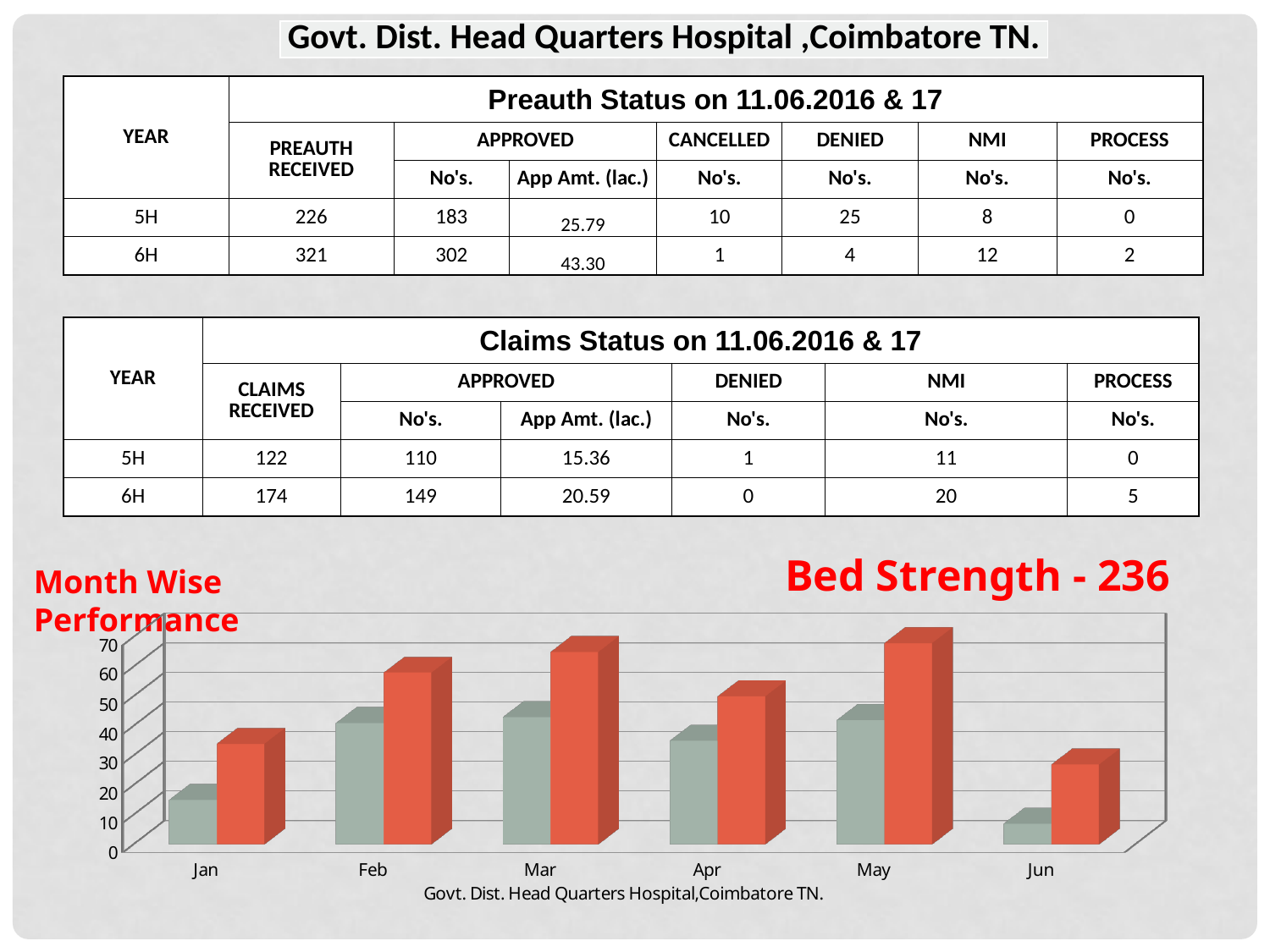
In the Month Wise Performance chart, is the red bar for May greater or less than 60? greater In the Month Wise Performance chart, which month has the lowest red bar? Jun In the Month Wise Performance chart, which is larger, the red bar for Feb or the red bar for Jan? Feb In the Month Wise Performance chart, is the grey bar for Jun greater or less than 10? less How many months are shown on the x axis of the Month Wise Performance chart? 6 What kind of chart is the Month Wise Performance chart? bar chart In the Month Wise Performance chart, is the grey bar for Jan greater or less than 20? less In the Month Wise Performance chart, which month has the lowest grey bar? Jun In the Month Wise Performance chart, which is larger, the grey bar for Apr or the grey bar for Jun? Apr What text appears below the x axis of the Month Wise Performance chart? Govt. Dist. Head Quarters Hospital,Coimbatore TN.